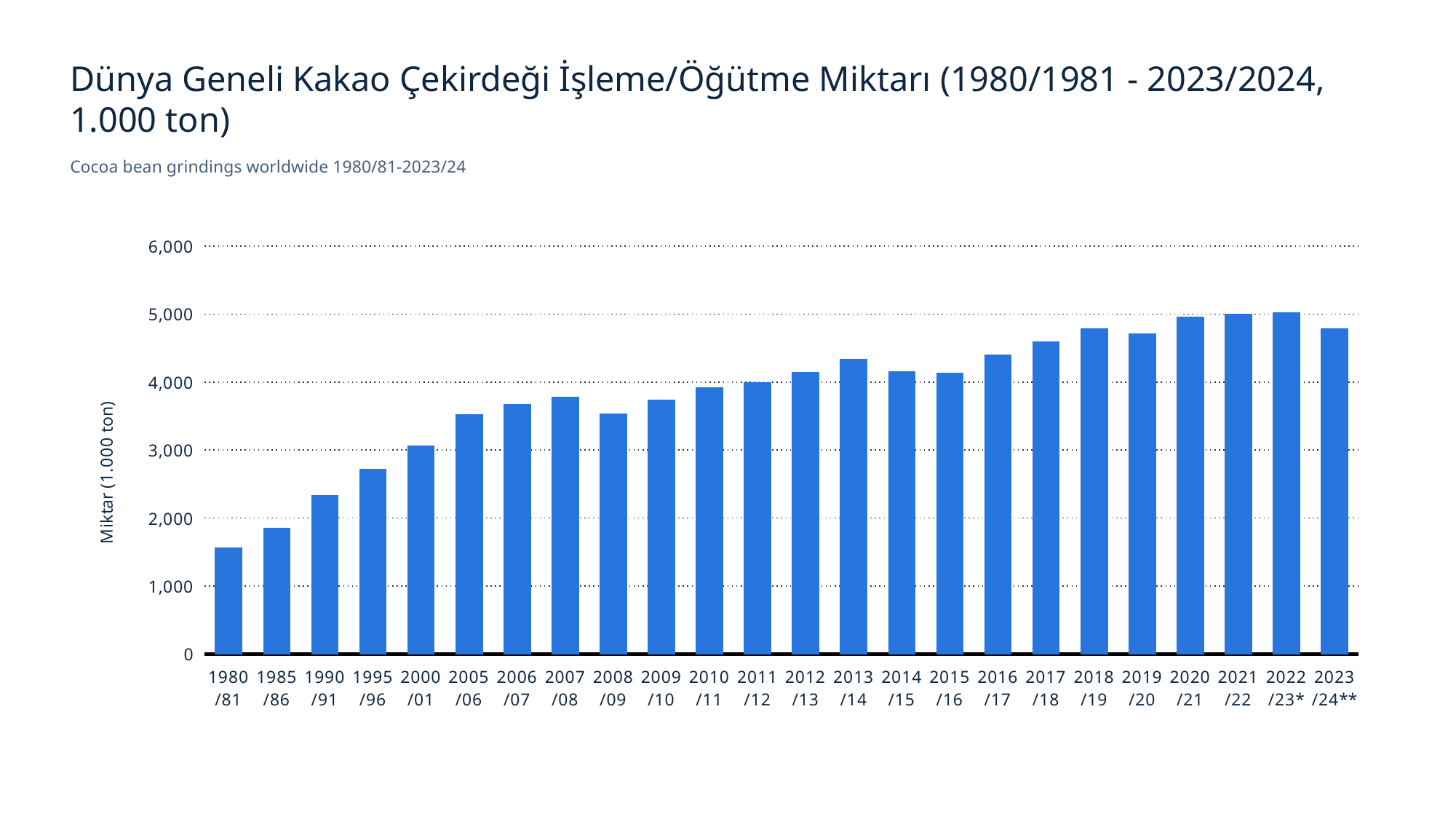
Do the values generally rise or fall from 1980/81 to 2022/23*? rise Is the value for 1990/91 greater or less than 2,000? greater Is the value for 1980/81 greater or less than 2,000? less Is the value for 2005/06 greater or less than 3,000? greater What is the label of the vertical axis? Miktar (1.000 ton) What kind of chart is shown on the slide? bar chart Which is larger, the value for 2007/08 or the value for 2008/09? 2007/08 Which season has the lowest cocoa bean grinding amount? 1980/81 How many bars (seasons) are plotted on the chart? 24